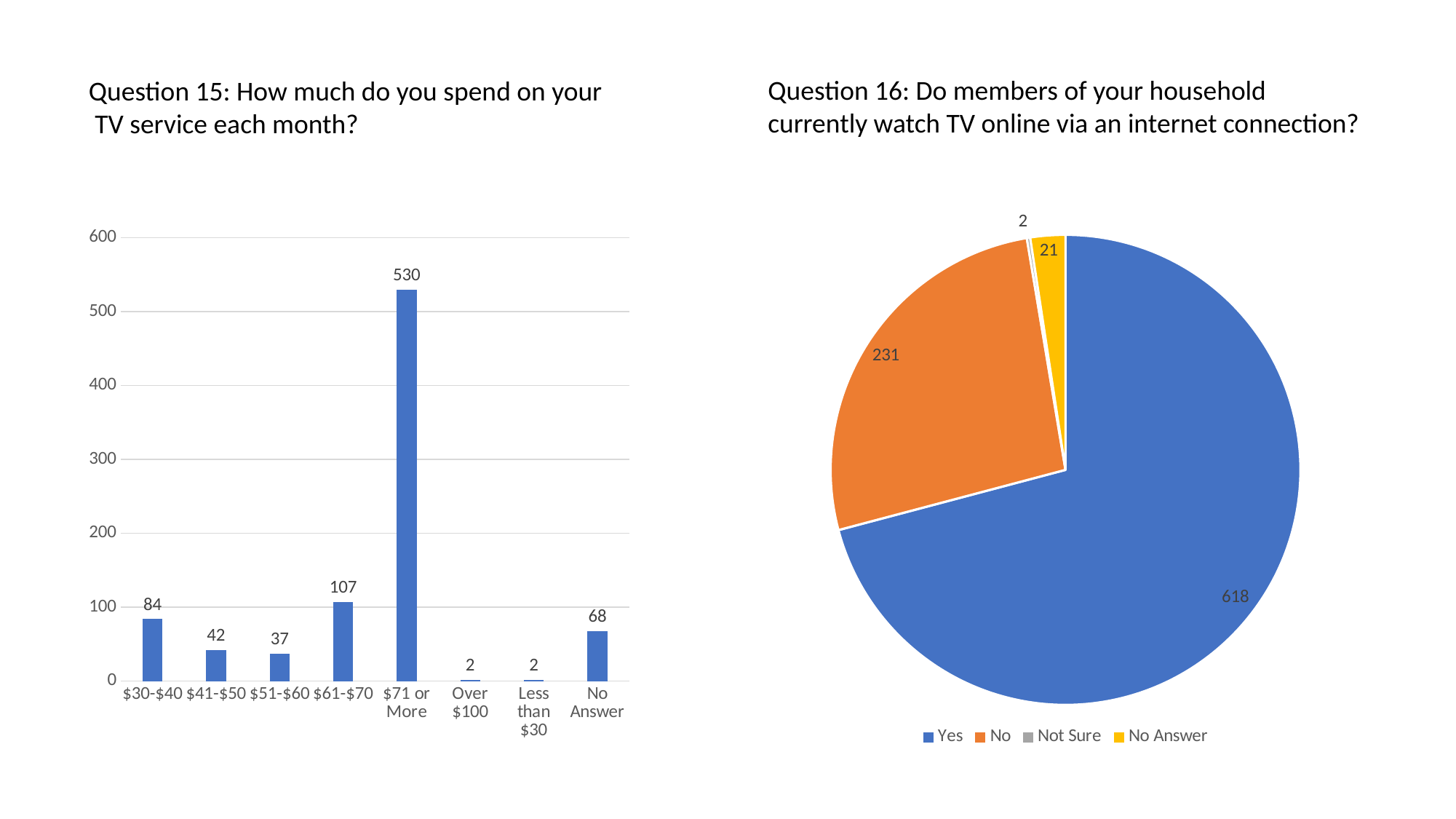
In the Question 16 pie chart, which category has the largest slice? Yes How many entries does the legend of the Question 16 pie chart list? 4 In the Question 15 bar chart, how many categories are shown on the x axis? 8 What kind of chart is used for Question 15? Bar chart In the Question 16 pie chart, what is the value for No? 231 In the Question 15 bar chart, what is the difference between the values for $30-$40 and $41-$50? 42 In the Question 16 pie chart, what is the difference between the values for Yes and No? 387 In the Question 15 bar chart, what is the value for $61-$70? 107 In the Question 15 bar chart, which category has the highest value? $71 or More In the Question 15 bar chart, what is the value for No Answer? 68 In the Question 15 bar chart, which is larger, the value for $51-$60 or the value for No Answer? No Answer In the Question 16 pie chart, what is the value for Not Sure? 2